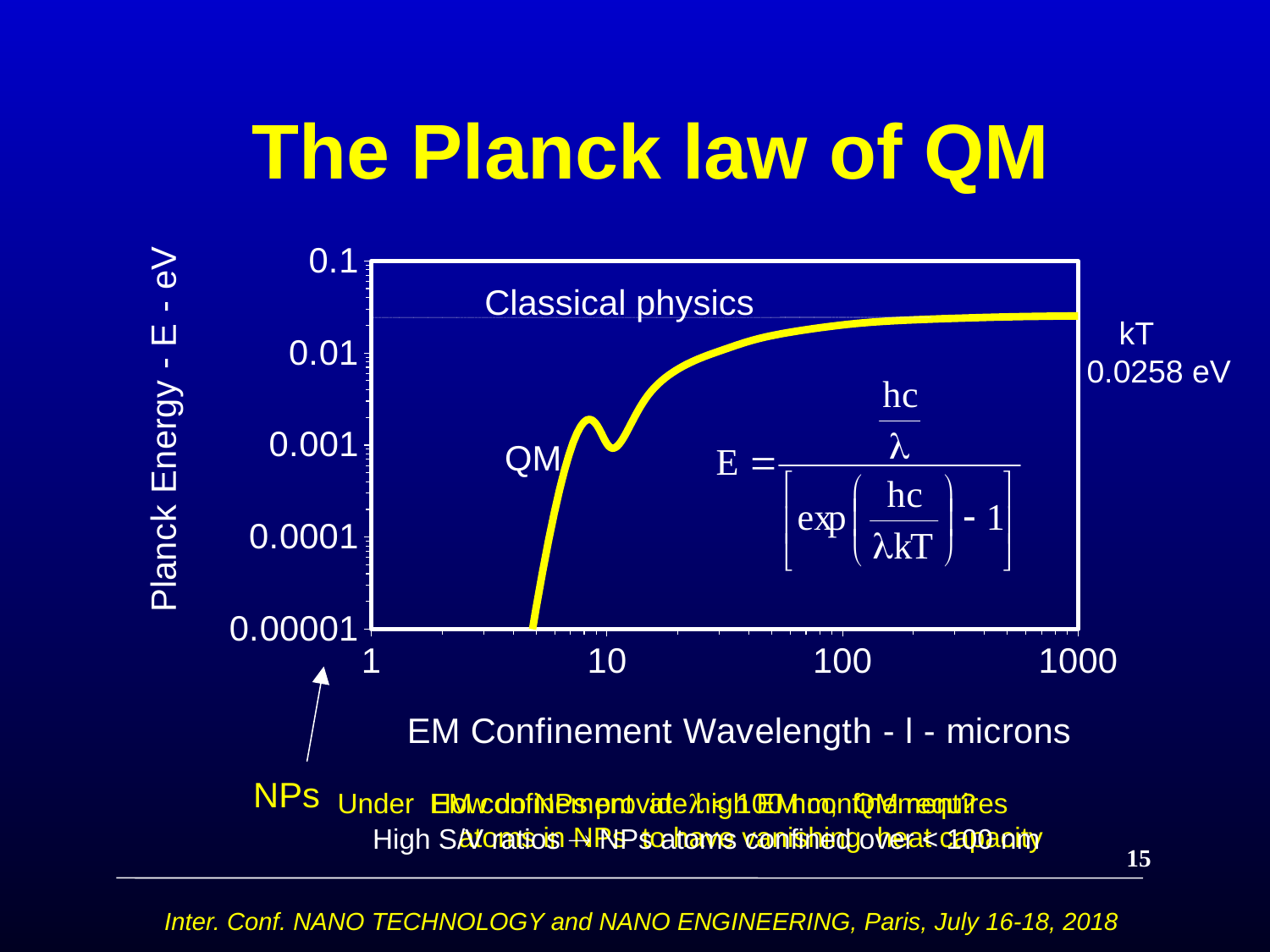
What value of kT is printed next to the chart? 0.0258 eV Is the Planck Energy at a wavelength of 1000 microns greater or less than 0.01? greater What is the lowest value labelled on the y axis? 0.00001 What is the title of the slide's chart? The Planck law of QM Does the Planck Energy curve rise or fall as the EM Confinement Wavelength increases from 1 to 1000 microns? rise Is the Planck Energy at a wavelength of 1000 microns greater or less than 0.1? less What is the label of the y axis? Planck Energy - E - eV Is the Planck Energy at a wavelength of 100 microns greater or less than 0.001? greater What is the highest value labelled on the y axis? 0.1 How many tick labels are shown on the x axis? 4 What kind of chart is shown on the slide? line chart How many tick labels are shown on the y axis? 5